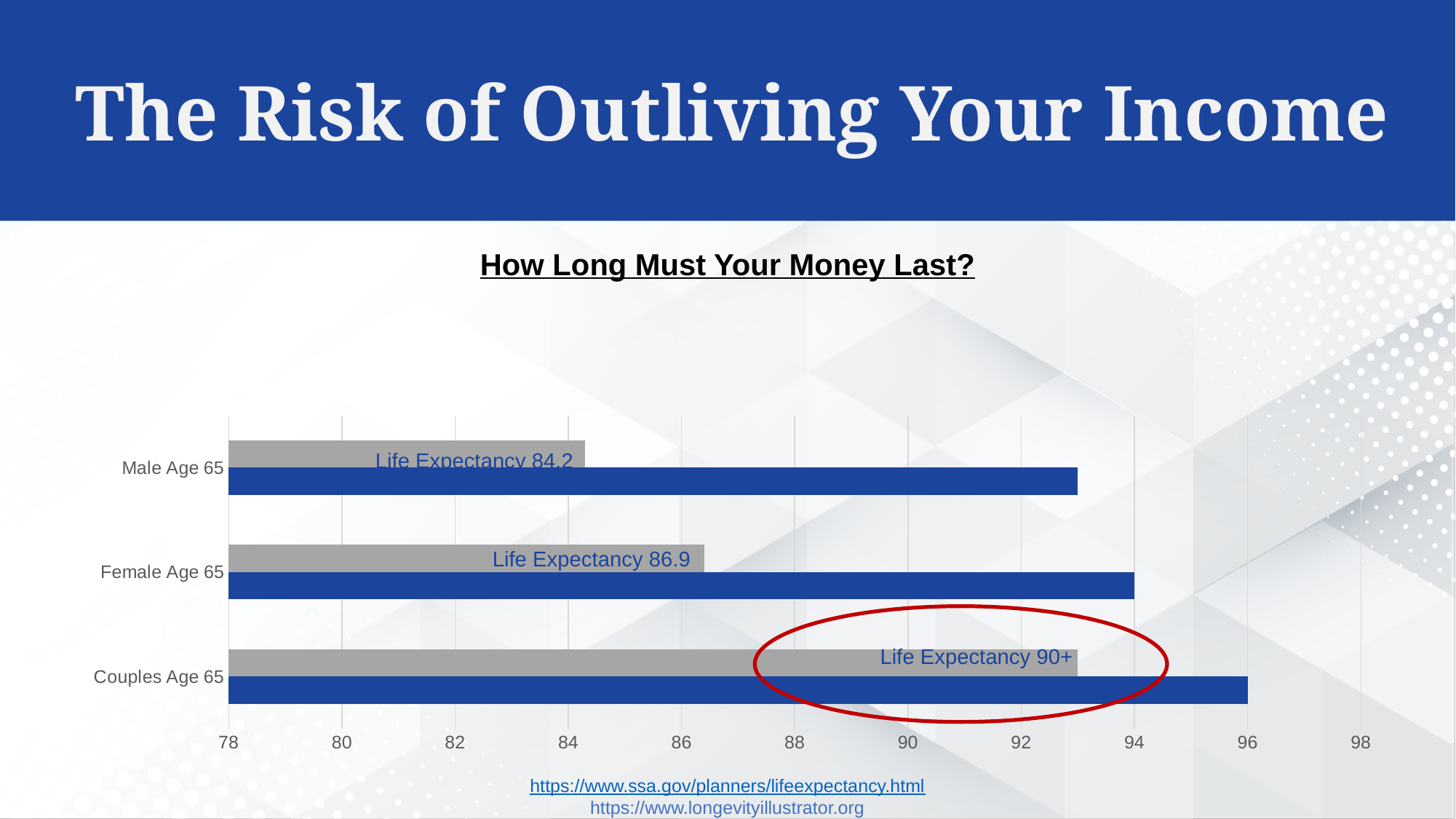
Which category has the lowest labelled life expectancy? Male Age 65 Is the blue bar for Couples Age 65 greater or less than 94? greater Which category has the highest labelled life expectancy? Couples Age 65 Is the blue bar for Male Age 65 greater or less than 94? less Which has the longer blue bar, Couples Age 65 or Female Age 65? Couples Age 65 How many categories are shown on the chart? 3 What is the title shown above the chart? How Long Must Your Money Last? What kind of chart is shown on the slide? bar chart What is the life expectancy shown for Female Age 65? 86.9 What is the life expectancy shown for Couples Age 65? 90+ What is the life expectancy shown for Male Age 65? 84.2 What is the difference between the life expectancy for Female Age 65 and Male Age 65? 2.7